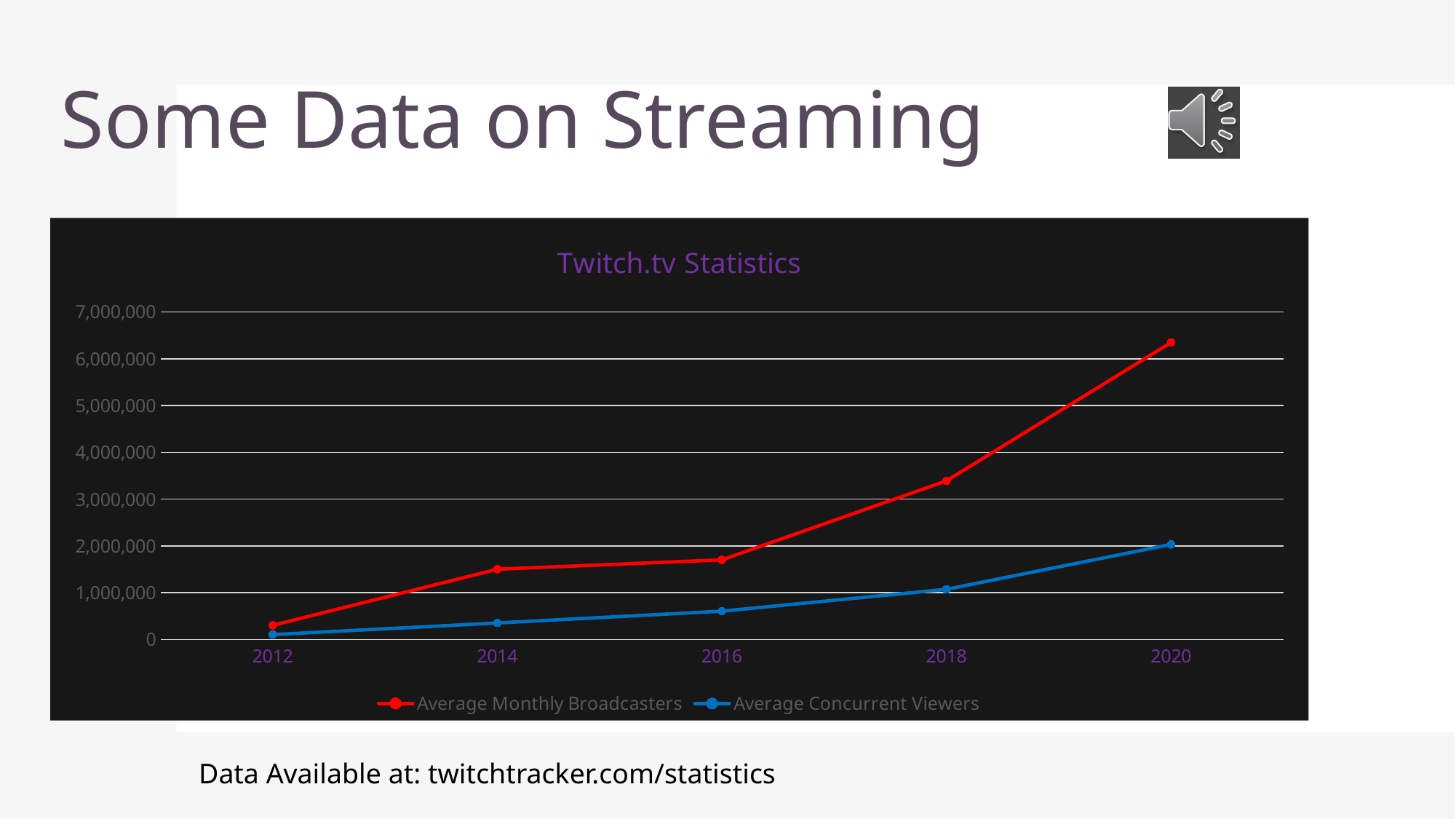
How many series does the legend list? 2 Is the value for Average Monthly Broadcasters in 2014 greater or less than 1,000,000? greater In which year is Average Monthly Broadcasters highest? 2020 In which year is Average Concurrent Viewers lowest? 2012 How many years are plotted along the x axis? 5 Is the value for Average Monthly Broadcasters in 2018 greater or less than 3,000,000? greater What kind of chart is shown on the slide? line chart Do the values for Average Concurrent Viewers rise or fall from 2012 to 2020? rise What is the title of the chart? Twitch.tv Statistics Is the value for Average Concurrent Viewers in 2016 greater or less than 1,000,000? less In 2020, which is larger: Average Monthly Broadcasters or Average Concurrent Viewers? Average Monthly Broadcasters